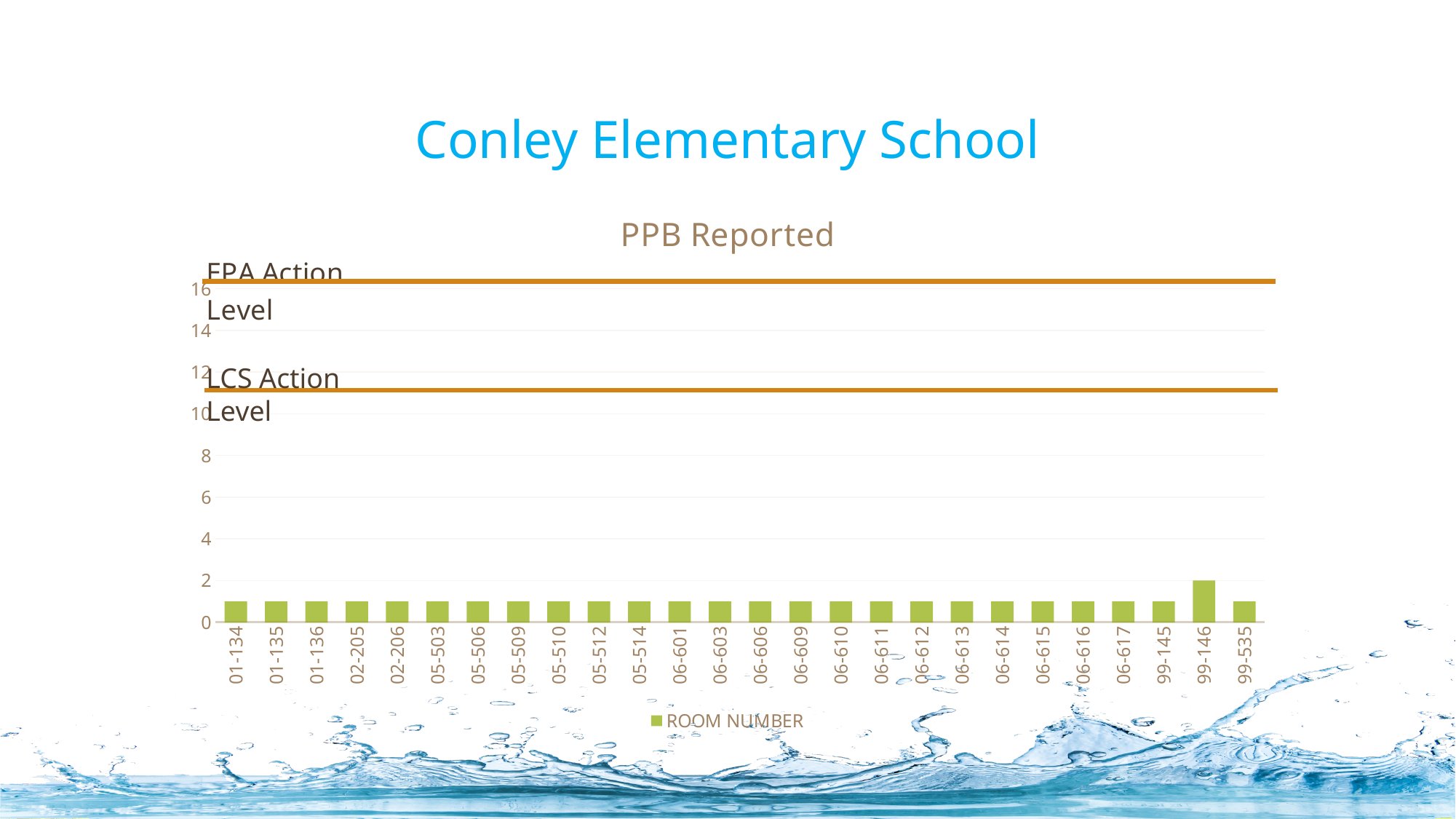
Is the PPB Reported value for room 05-510 greater or less than 6? less Which room number has the highest PPB Reported value? 99-146 How many series does the legend of the PPB Reported chart list? 1 Which is larger, the PPB Reported value for room 99-146 or for room 99-535? 99-146 What is the title of the chart on the slide? PPB Reported What is the legend entry for the bars in the PPB Reported chart? ROOM NUMBER Is the PPB Reported value for room 99-146 greater or less than 10? less What kind of chart is shown under the title "PPB Reported"? bar chart Is the PPB Reported value for room 06-612 greater or less than 4? less How many room numbers are shown on the x axis of the PPB Reported chart? 26 What is the PPB Reported value for room 99-146? 2